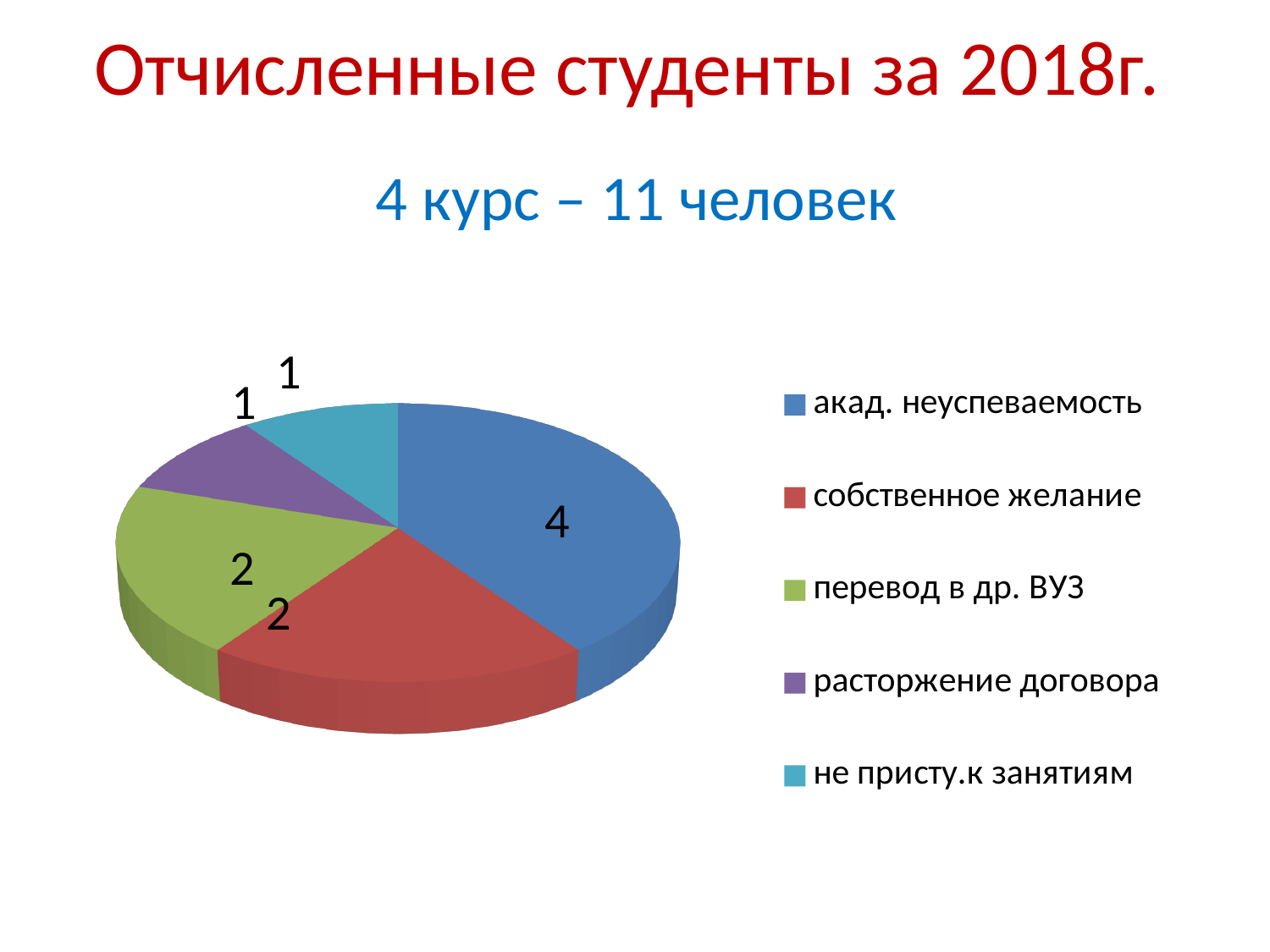
Which category has the largest slice of the pie? акад. неуспеваемость What is the difference between the values for акад. неуспеваемость and расторжение договора? 3 Which is larger, акад. неуспеваемость or собственное желание? акад. неуспеваемость How many entries does the legend list? 5 What type of chart is shown on the slide? pie chart What is the value for расторжение договора? 1 What is the value for не присту.к занятиям? 1 How many categories does the pie chart show? 5 What is the value for акад. неуспеваемость? 4 What colour is the slice for перевод в др. ВУЗ? green What is the value for собственное желание? 2 What is the value for перевод в др. ВУЗ? 2